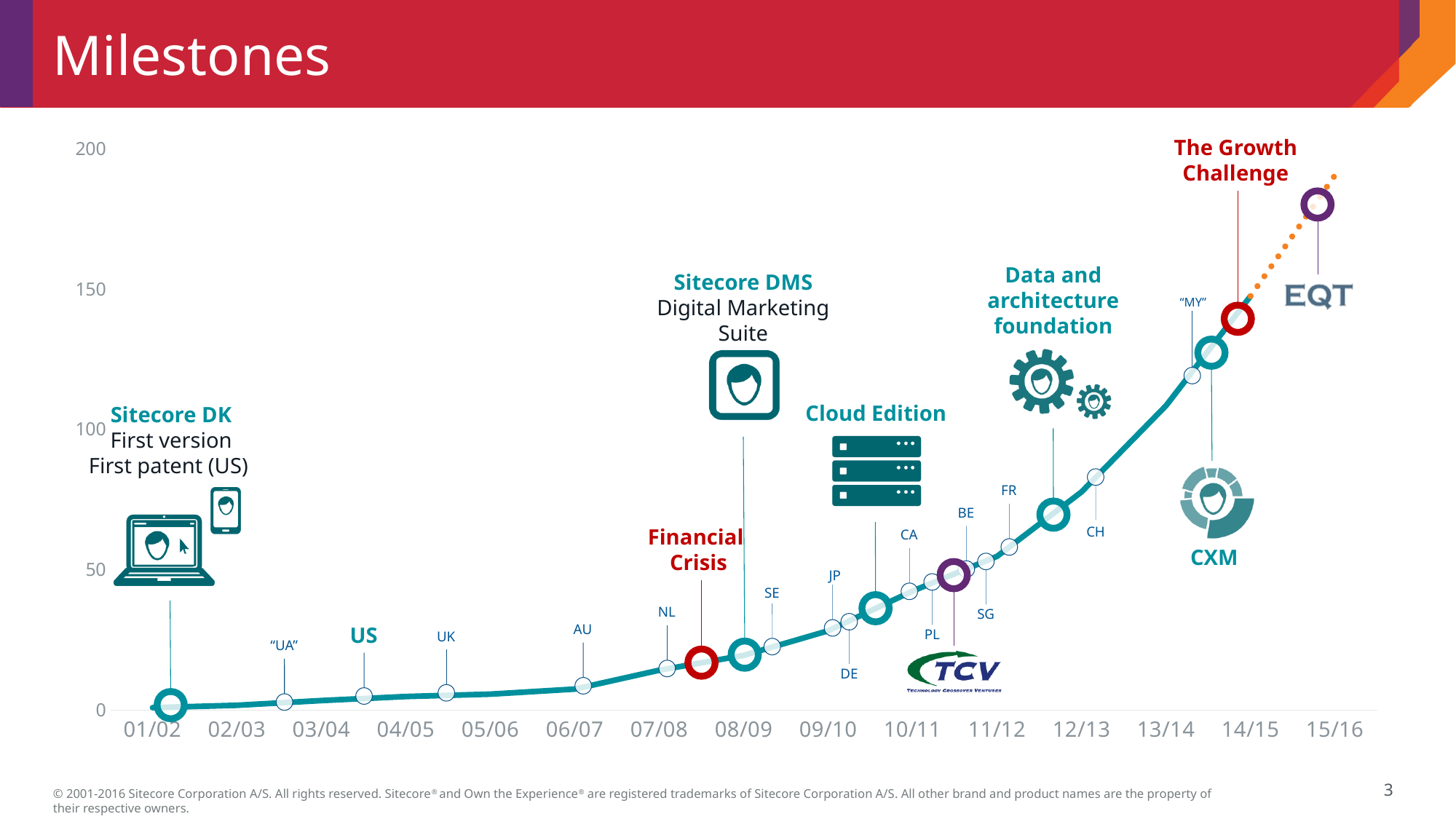
Is the value at 08/09 greater or less than 50? less Which x-axis period has the highest plotted value? 15/16 Do the plotted values rise or fall from 01/02 to 15/16? rise What kind of chart is shown on the slide? line chart Which has the larger plotted value, 13/14 or 06/07? 13/14 What is the title of the slide containing the chart? Milestones Is the value at 14/15 greater or less than 100? greater Which x-axis period has the lowest plotted value? 01/02 How many period labels are shown along the x axis? 15 What is the highest tick value shown on the y axis? 200 Is the value at 15/16 greater or less than 150? greater